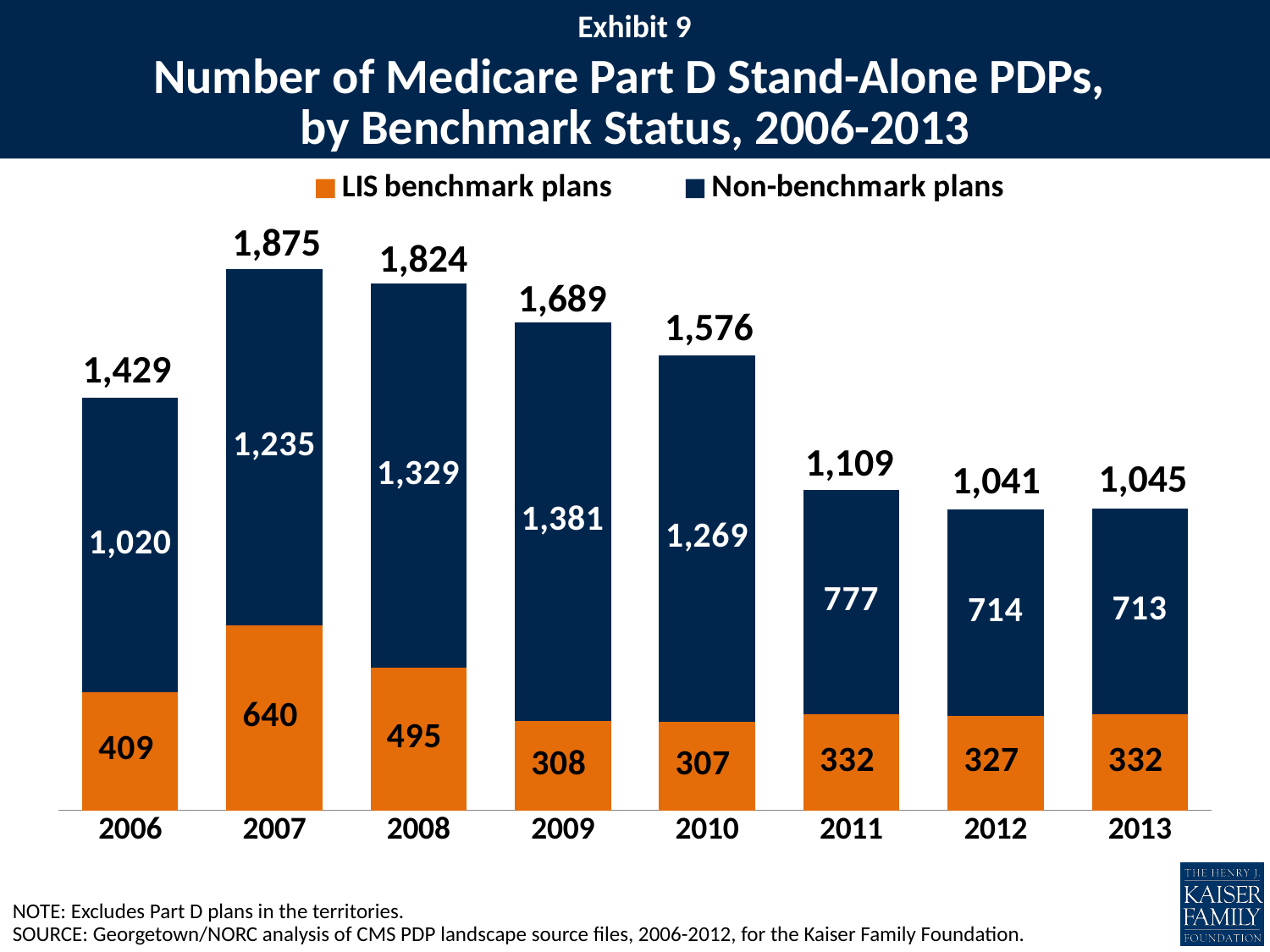
Which year has the lowest number of LIS benchmark plans? 2010 Does the total number of stand-alone PDPs rise or fall from 2007 to 2012? Fall What is the number of non-benchmark plans in 2009? 1,381 What is the total number of stand-alone PDPs in 2010? 1,576 What is the difference between the total number of PDPs in 2007 and in 2013? 830 Which year has the highest total number of stand-alone PDPs? 2007 Which is larger: the number of non-benchmark plans in 2008 or in 2010? 2008 Which colour represents LIS benchmark plans in the chart? Orange How many years are shown on the x axis? 8 What kind of chart is shown on the slide? Stacked bar chart How many series does the legend list? 2 What is the number of LIS benchmark plans in 2007? 640